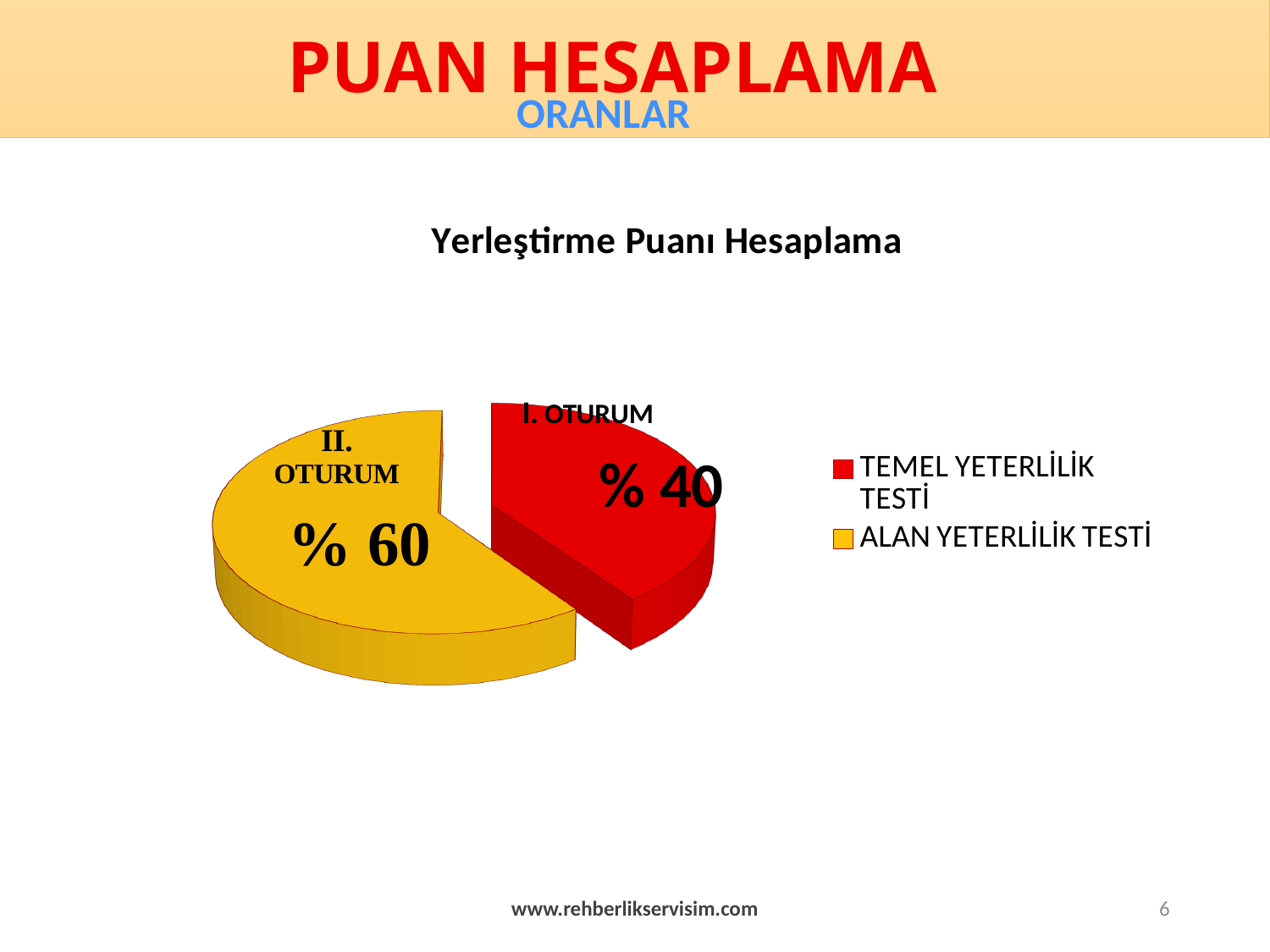
Which legend entry is shown in red? TEMEL YETERLİLİK TESTİ What kind of chart is shown on the slide? pie chart What is the difference in percentage points between the II. OTURUM and I. OTURUM slices? 20 Which slice is the largest? II. OTURUM What is the chart's title? Yerleştirme Puanı Hesaplama Which is larger, the I. OTURUM slice or the II. OTURUM slice? II. OTURUM How many entries does the legend list? 2 What share of the pie does the I. OTURUM slice represent? % 40 Which slice is the smallest? I. OTURUM How many slices does the pie chart have? 2 What share of the pie does the II. OTURUM slice represent? % 60